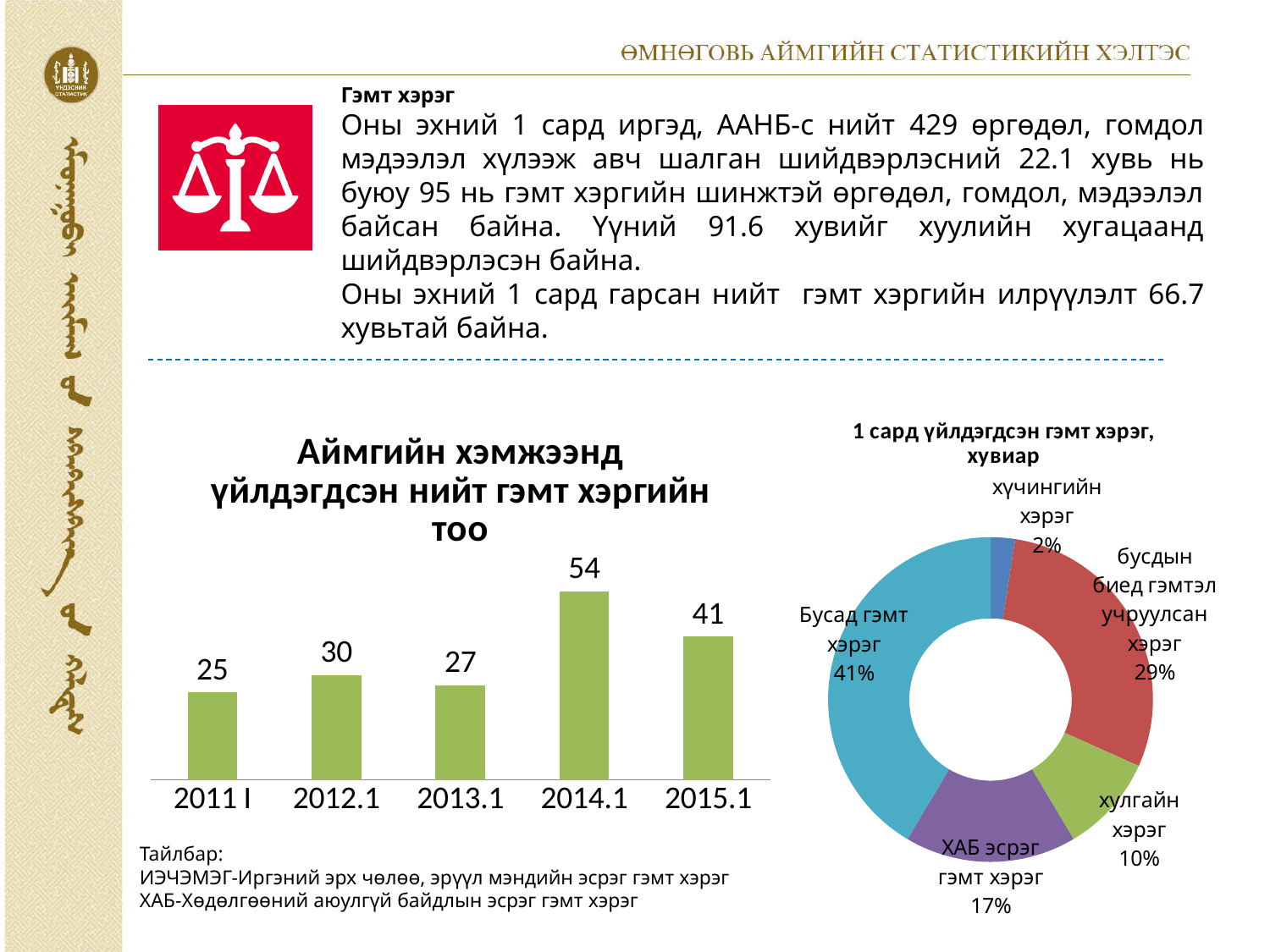
What kind of chart is '1 сард үйлдэгдсэн гэмт хэрэг, хувиар'? Doughnut chart In the bar chart 'Аймгийн хэмжээнд үйлдэгдсэн нийт гэмт хэргийн тоо', what is the difference between the values for 2014.1 and 2015.1? 13 In the chart '1 сард үйлдэгдсэн гэмт хэрэг, хувиар', what share does 'хулгайн хэрэг' have? 10% What kind of chart is 'Аймгийн хэмжээнд үйлдэгдсэн нийт гэмт хэргийн тоо'? Bar chart In the bar chart 'Аймгийн хэмжээнд үйлдэгдсэн нийт гэмт хэргийн тоо', which period has the lowest value? 2011 I In the bar chart 'Аймгийн хэмжээнд үйлдэгдсэн нийт гэмт хэргийн тоо', which is larger, the value for 2012.1 or 2013.1? 2012.1 How many bars are in the bar chart 'Аймгийн хэмжээнд үйлдэгдсэн нийт гэмт хэргийн тоо'? 5 In the bar chart 'Аймгийн хэмжээнд үйлдэгдсэн нийт гэмт хэргийн тоо', what is the value for 2014.1? 54 In the chart '1 сард үйлдэгдсэн гэмт хэрэг, хувиар', which category has the smallest share? хүчингийн хэрэг In the chart '1 сард үйлдэгдсэн гэмт хэрэг, хувиар', what share does 'Бусад гэмт хэрэг' have? 41% In the bar chart 'Аймгийн хэмжээнд үйлдэгдсэн нийт гэмт хэргийн тоо', what is the value for 2011 I? 25 In the bar chart 'Аймгийн хэмжээнд үйлдэгдсэн нийт гэмт хэргийн тоо', which period has the highest value? 2014.1